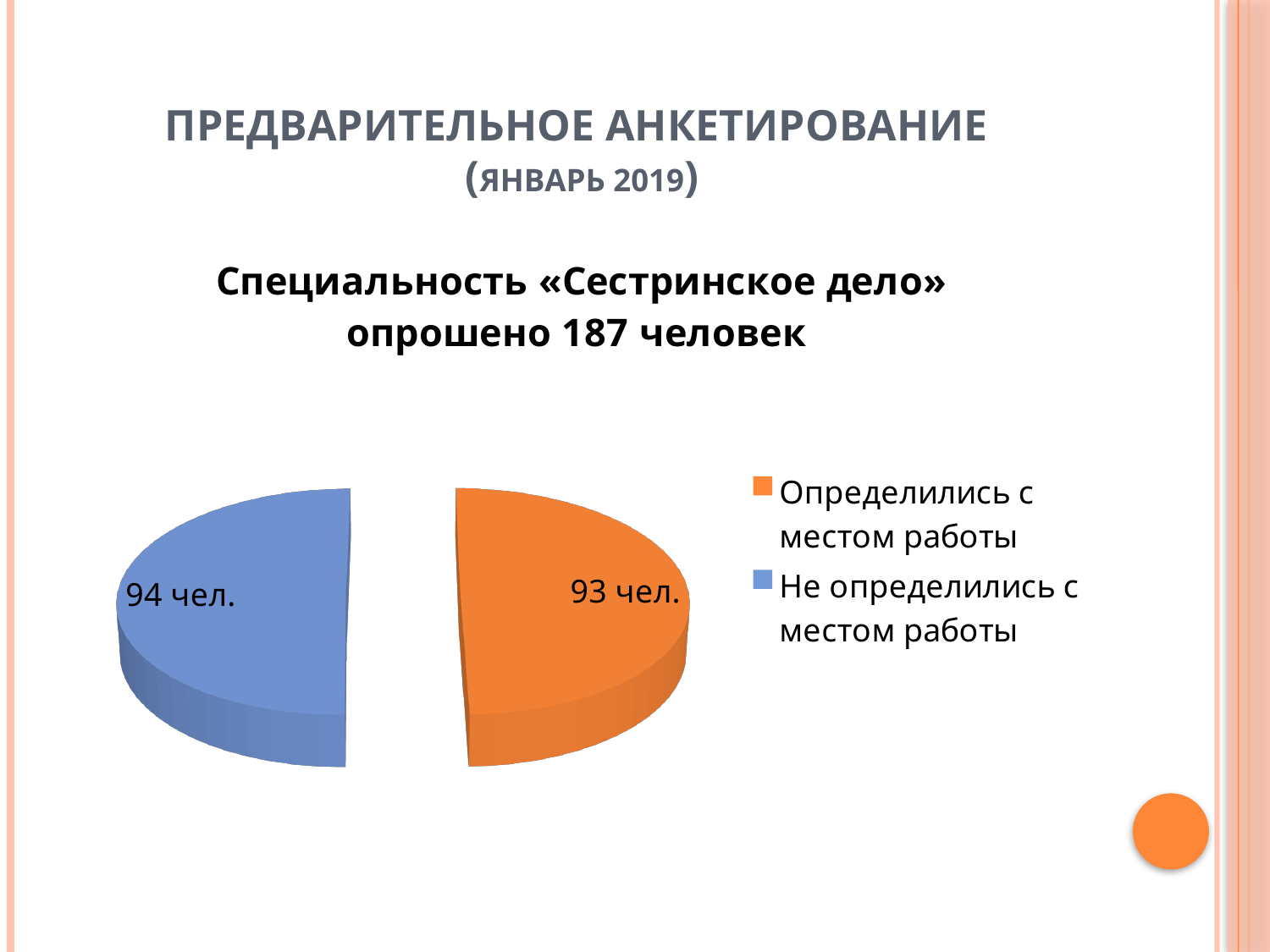
Which category has the lowest value? Определились с местом работы What is the difference between «Не определились с местом работы» and «Определились с местом работы»? 1 чел. Which slice is larger: «Определились с местом работы» or «Не определились с местом работы»? Не определились с местом работы What kind of chart is shown on the slide? Pie chart What colour is the slice for «Определились с местом работы»? Orange How many slices does the pie chart have? 2 Which category has the highest value? Не определились с местом работы What is the value for «Определились с местом работы»? 93 чел. What is the value for «Не определились с местом работы»? 94 чел. How many entries does the legend list? 2 What colour is the slice for «Не определились с местом работы»? Blue What is the total of the two slices in the pie chart? 187 чел.